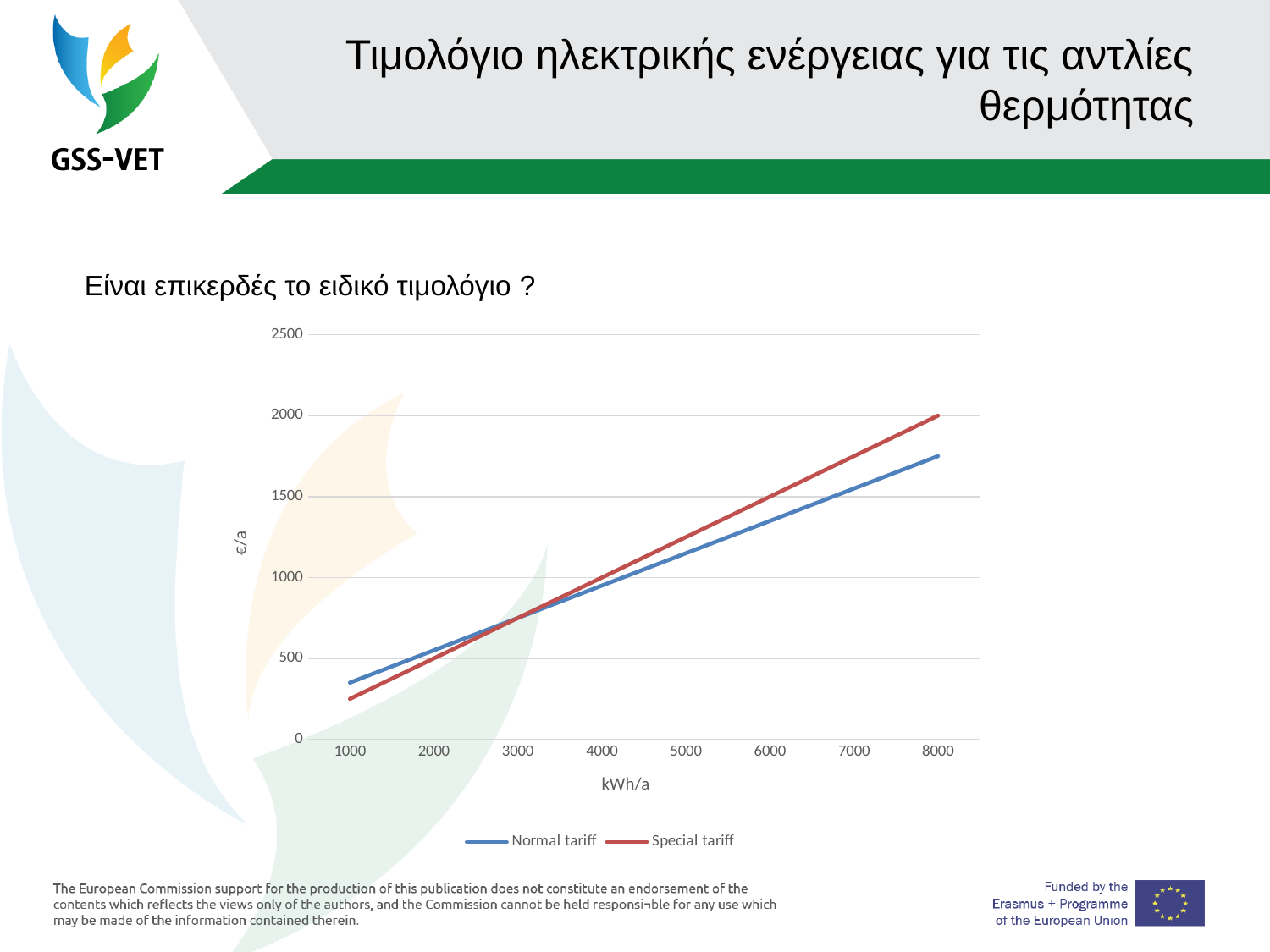
Is the value for Special tariff at 1000 kWh/a greater or less than 500? less At 8000 kWh/a, which series has the higher value, Normal tariff or Special tariff? Special tariff How many tick values are shown on the x axis? 8 How many series does the legend list? 2 What are the two series named in the legend? Normal tariff and Special tariff Is the value for Special tariff at 6000 kWh/a greater or less than 1000? greater Do the values of the Normal tariff series rise or fall as kWh/a increases? rise What is the label of the x axis? kWh/a Do the values of the Special tariff series rise or fall as kWh/a increases? rise What kind of chart is shown on the slide? line chart Is the value for Normal tariff at 8000 kWh/a greater or less than 1500? greater At 1000 kWh/a, which series has the higher value, Normal tariff or Special tariff? Normal tariff